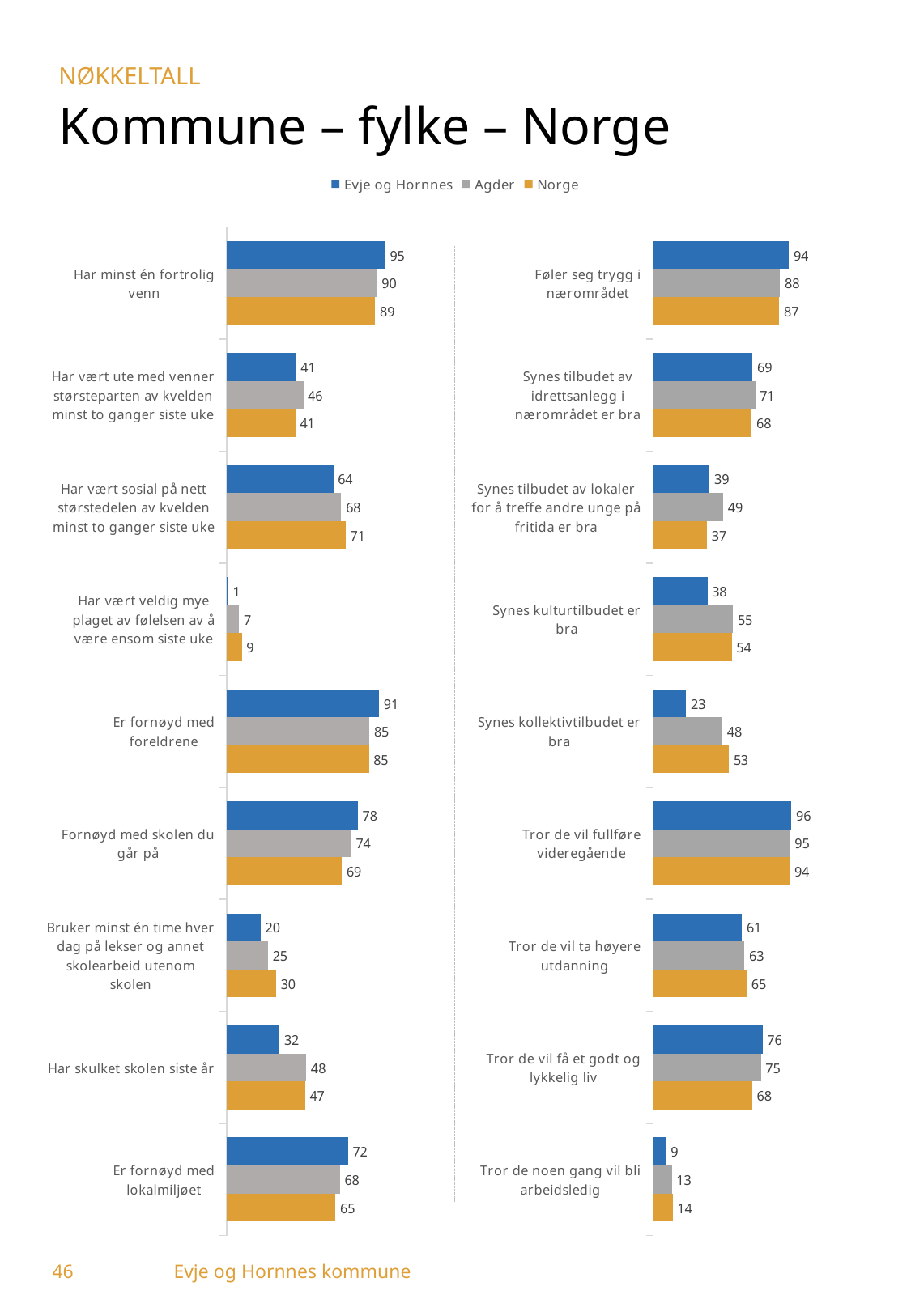
In the left chart, what is the value for Evje og Hornnes for 'Har minst én fortrolig venn'? 95 What kind of chart is used on this slide? Bar chart In the right chart, what is the value for Norge for 'Synes kollektivtilbudet er bra'? 53 In the right chart, which category has the highest value for Evje og Hornnes? Tror de vil fullføre videregående In the left chart, what is the value for Agder for 'Har skulket skolen siste år'? 48 How many categories are shown in the left chart? 9 In the right chart, what is the difference between Agder and Evje og Hornnes for 'Synes kollektivtilbudet er bra'? 25 In the right chart, what is the difference between Norge and Evje og Hornnes for 'Tror de vil få et godt og lykkelig liv'? 8 In the left chart, which is larger for 'Fornøyd med skolen du går på': Evje og Hornnes or Norge? Evje og Hornnes How many series does the legend list? 3 Which colour represents Norge in the legend? Orange In the left chart, which category has the lowest value for Norge? Har vært veldig mye plaget av følelsen av å være ensom siste uke